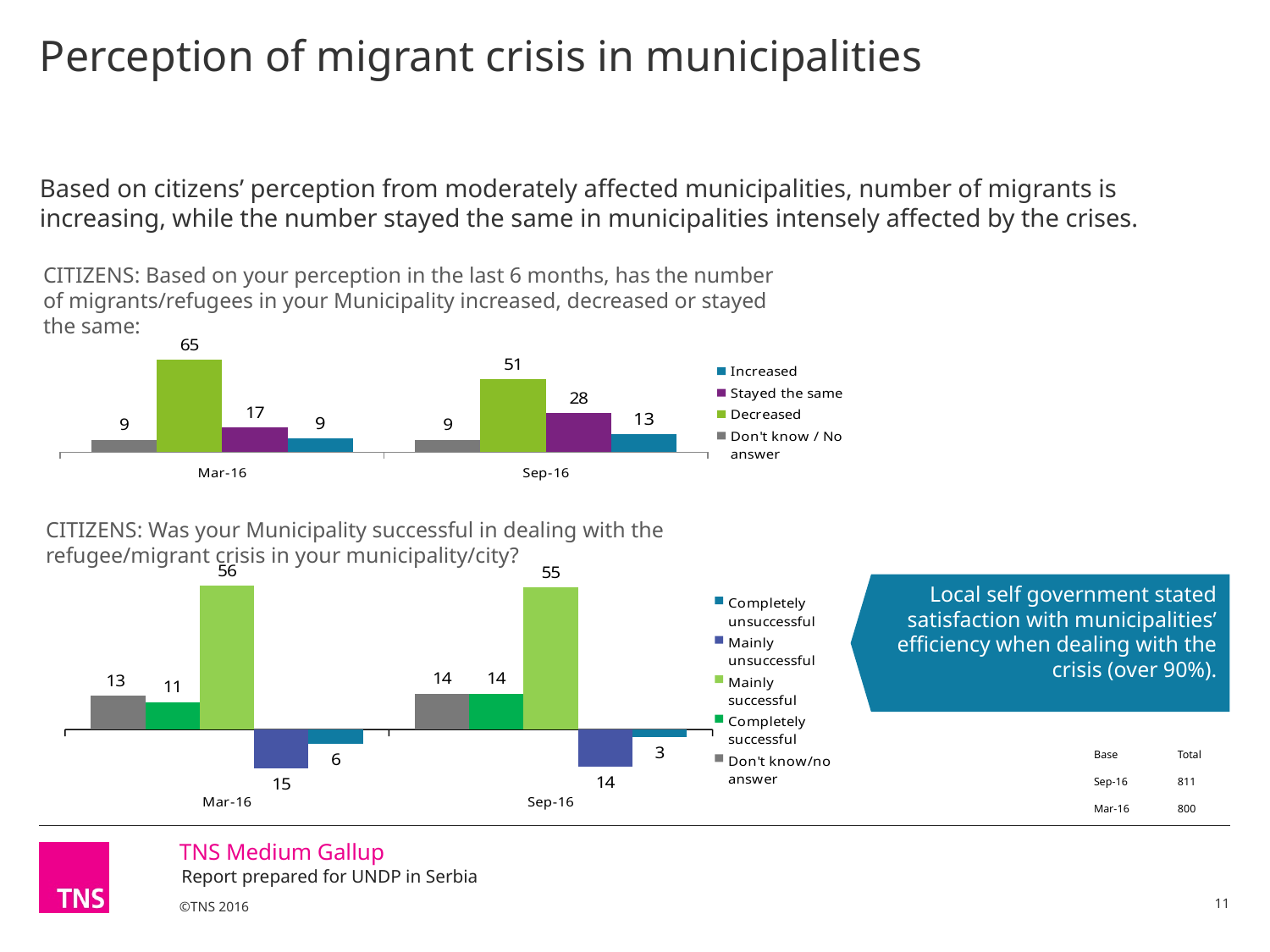
How many series does the legend of the top chart (number of migrants/refugees increased, decreased or stayed the same) list? 4 In the bottom chart (was your Municipality successful in dealing with the crisis), what is the value for 'Mainly successful' in Mar-16? 56 In the bottom chart (was your Municipality successful in dealing with the crisis), is the 'Completely unsuccessful' value larger in Mar-16 or Sep-16? Mar-16 In the bottom chart (was your Municipality successful in dealing with the crisis), what is the value for 'Mainly unsuccessful' in Sep-16? 14 In the top chart (number of migrants/refugees increased, decreased or stayed the same), by how much did the 'Decreased' value fall from Mar-16 to Sep-16? 14 What type of chart is the top chart about whether the number of migrants/refugees increased, decreased or stayed the same? Bar chart How many time periods are shown on the x axis of the bottom chart (was your Municipality successful in dealing with the crisis)? 2 In the top chart (number of migrants/refugees increased, decreased or stayed the same), which series has the highest value in Sep-16? Decreased In the top chart (number of migrants/refugees increased, decreased or stayed the same), what is the value for 'Increased' in Sep-16? 13 In the top chart (number of migrants/refugees increased, decreased or stayed the same), what is the value for 'Decreased' in Mar-16? 65 In the top chart (number of migrants/refugees increased, decreased or stayed the same), what is the value for 'Stayed the same' in Sep-16? 28 How many series does the legend of the bottom chart (was your Municipality successful in dealing with the crisis) list? 5